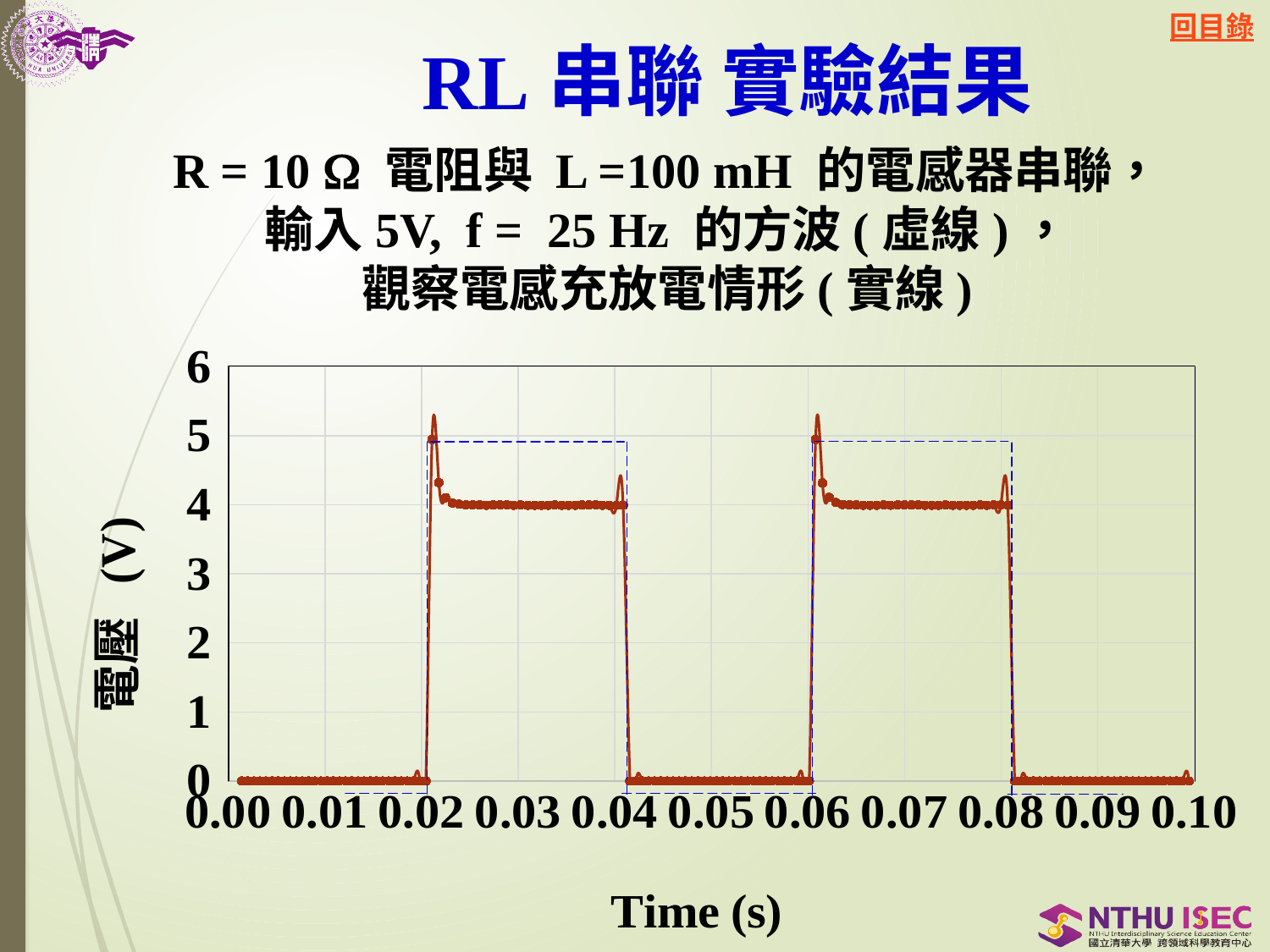
Is the value of the dashed line at 0.07 s greater or less than 4? greater What is the highest tick value shown on the y axis? 6 What is the label of the y axis of the chart? 電壓 (V) Between 0.02 s and 0.04 s, does the solid line rise or fall after its initial peak? fall Is the value of the solid line at 0.03 s greater or less than 5? less Is the value of the dashed line at 0.05 s greater or less than 1? less What kind of chart is shown on the slide? line chart How many high pulses of the dashed square wave are shown between 0.00 s and 0.10 s? 2 What is the label of the x axis of the chart? Time (s)